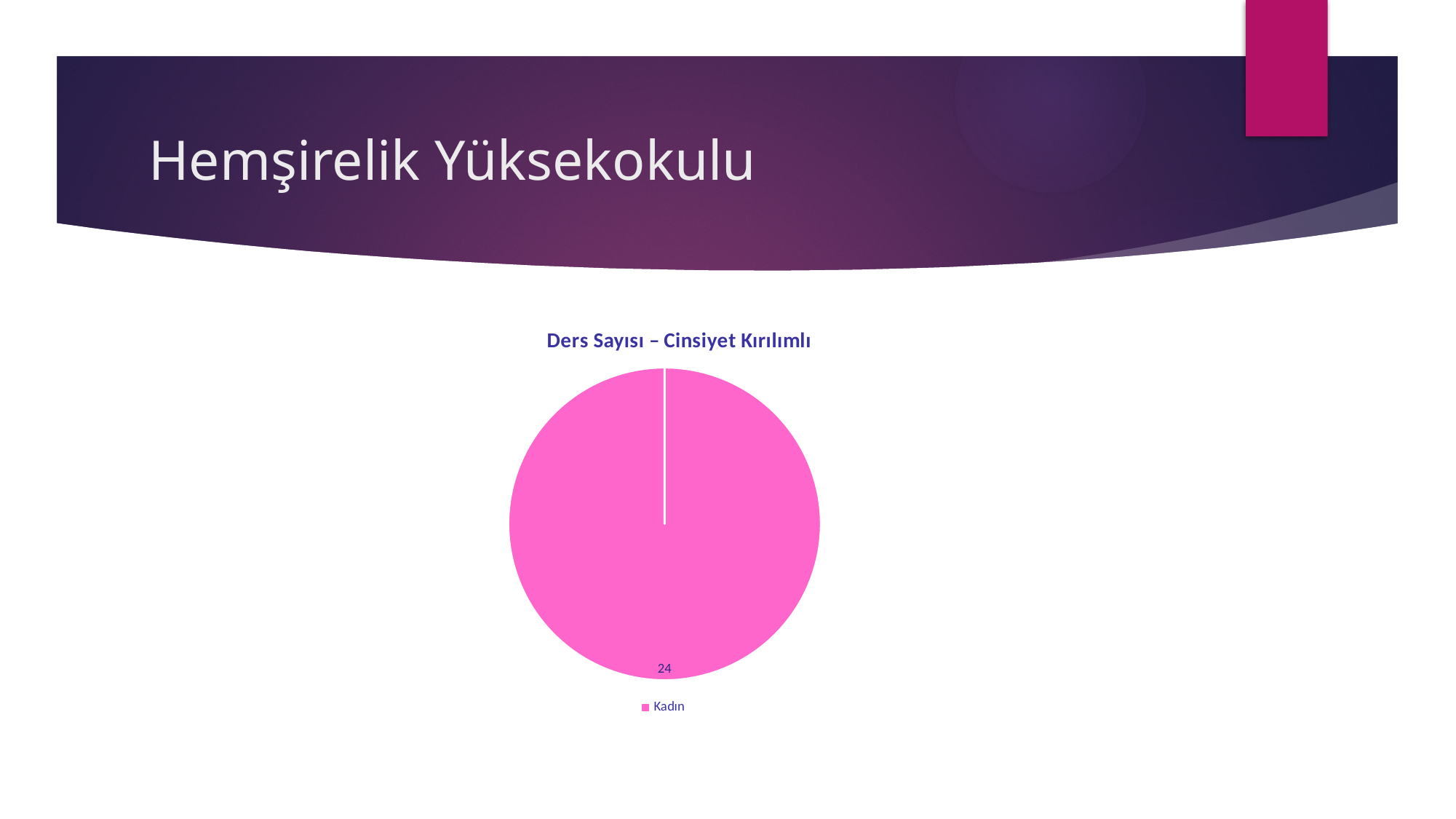
Which category is listed in the legend of the pie chart? Kadın What share of the pie does the Kadın slice take up? 100% What is the total of all slices in the pie chart? 24 What is the value for Kadın in the pie chart? 24 Is the value for Kadın greater or less than 20? greater How many categories does the legend of the pie chart list? 1 What kind of chart is shown on the slide? pie chart What is the title of the pie chart? Ders Sayısı – Cinsiyet Kırılımlı